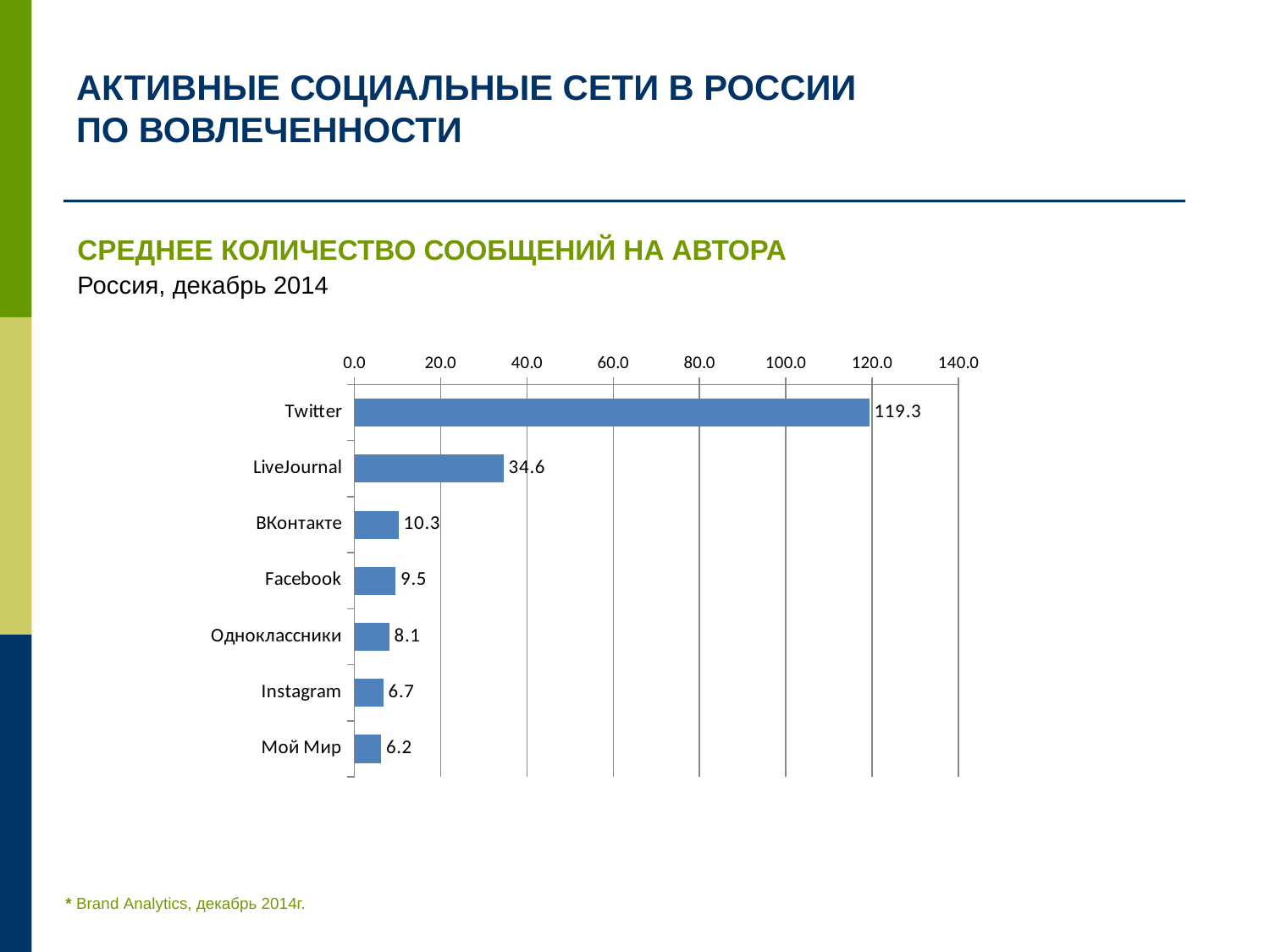
Which has a larger value, Instagram or Одноклассники? Одноклассники Which social network has the highest average number of messages per author? Twitter Which social network has the lowest average number of messages per author? Мой Мир What is the value shown for Одноклассники? 8.1 How many social networks are shown in the chart? 7 Is the value for Twitter greater or less than 100.0? greater What kind of chart is shown on the slide? bar chart What is the difference between the values for ВКонтакте and Facebook? 0.8 What is the value shown for LiveJournal? 34.6 What is the average number of messages per author for Twitter? 119.3 What is the title of the chart on the slide? СРЕДНЕЕ КОЛИЧЕСТВО СООБЩЕНИЙ НА АВТОРА What is the difference between the values for Twitter and LiveJournal? 84.7